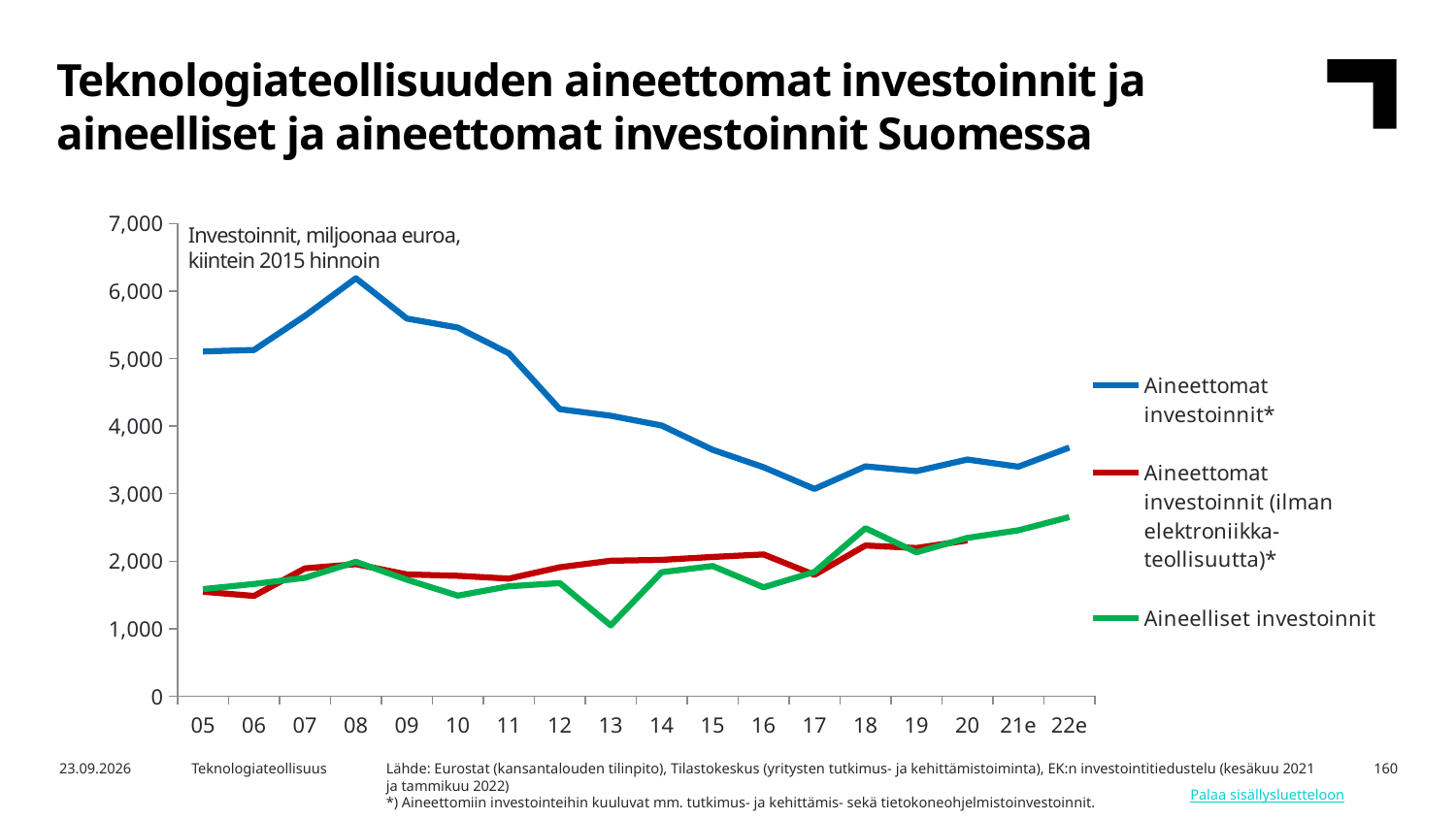
Does the Aineettomat investoinnit* series rise or fall from 08 to 17? fall Is the value for Aineettomat investoinnit* in 08 greater or less than 6,000? greater Does the Aineelliset investoinnit series rise or fall from 13 to 22e? rise In which year does the Aineelliset investoinnit series reach its lowest value? 13 How many series does the legend list? 3 What unit is stated in the text box inside the chart? Investoinnit, miljoonaa euroa, kiintein 2015 hinnoin What kind of chart is shown on the slide? line chart Which series has the higher value in 05: Aineettomat investoinnit* or Aineelliset investoinnit? Aineettomat investoinnit* Is the value for Aineettomat investoinnit* in 17 greater or less than 4,000? less Is the value for Aineelliset investoinnit in 13 greater or less than 2,000? less How many points are plotted along the x axis (from 05 to 22e)? 18 In which year does the Aineettomat investoinnit* series reach its highest value? 08